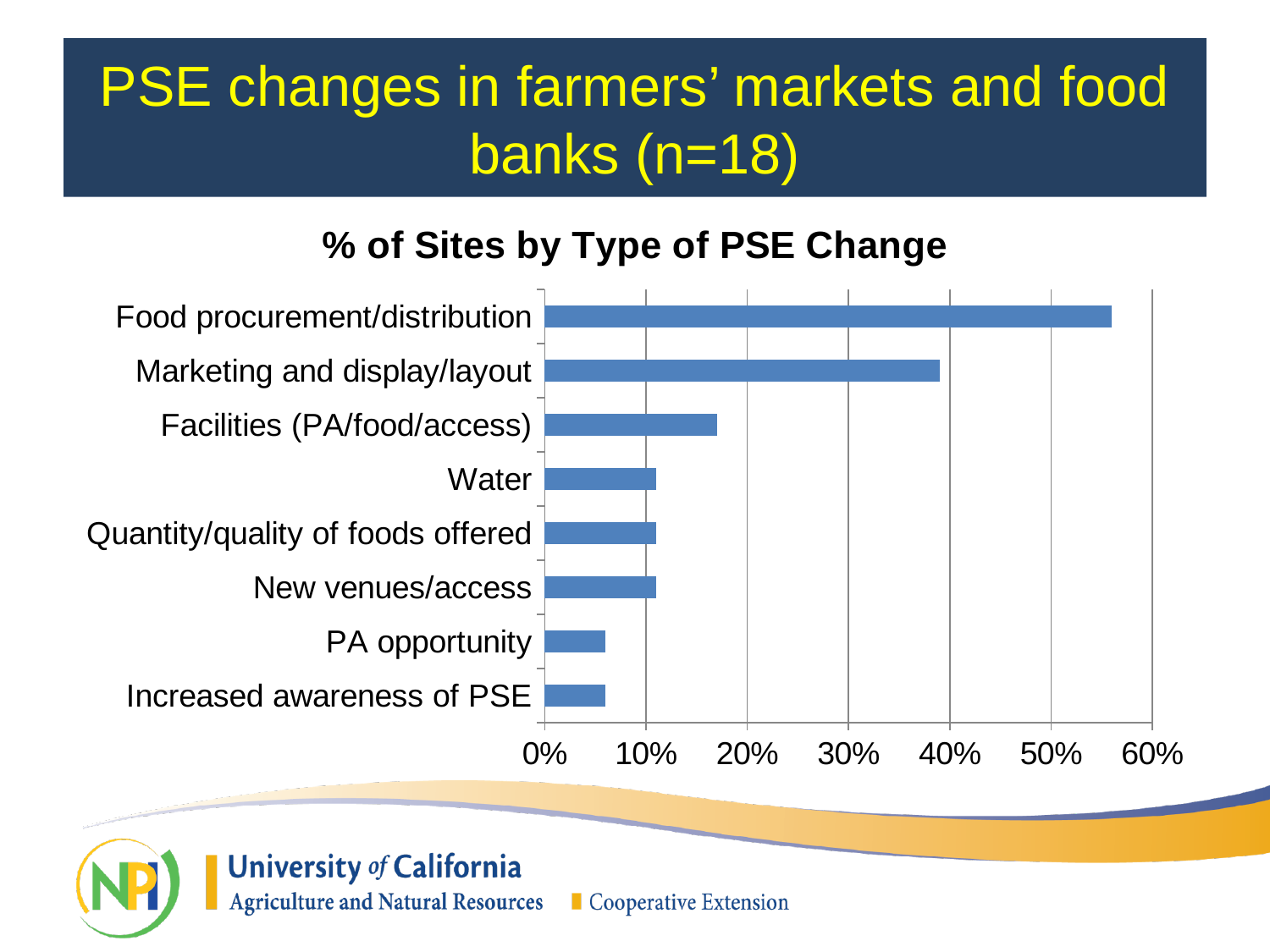
Is the value for Food procurement/distribution greater or less than 50%? greater Which is larger, the value for Marketing and display/layout or the value for Facilities (PA/food/access)? Marketing and display/layout Which type of PSE change has the highest percentage of sites? Food procurement/distribution What kind of chart is shown on the slide? bar chart Is the value for Marketing and display/layout greater or less than 40%? less Is the value for PA opportunity greater or less than 10%? less What is the title of the chart? % of Sites by Type of PSE Change Which is larger, the value for New venues/access or the value for Increased awareness of PSE? New venues/access How many types of PSE change are listed on the chart? 8 What is the highest value shown on the horizontal axis? 60%